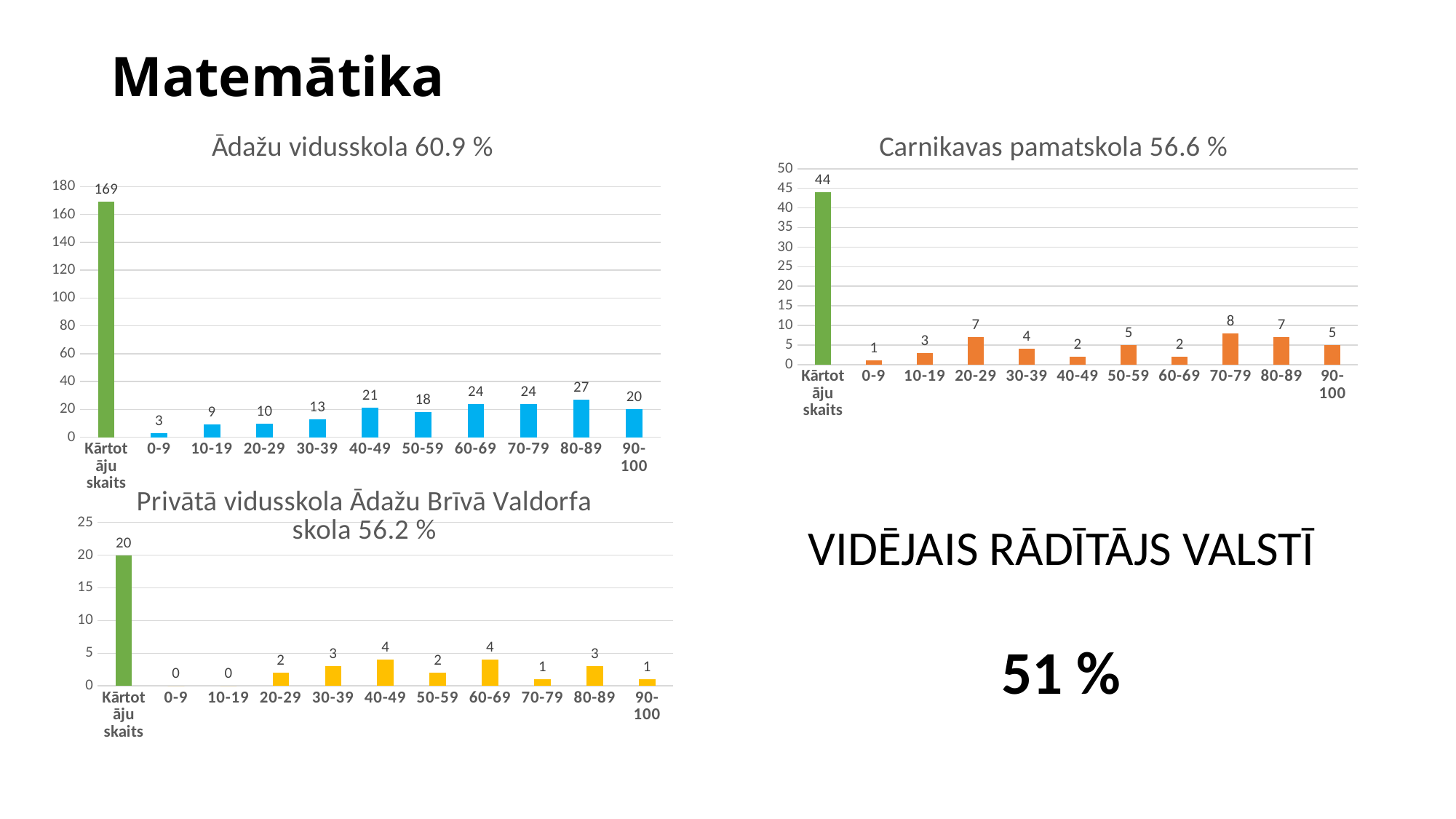
In the 'Ādažu vidusskola 60.9 %' chart, what is the value for the 80-89 category? 27 In the 'Carnikavas pamatskola 56.6 %' chart, is the value for 20-29 larger or smaller than the value for 30-39? larger In the 'Ādažu vidusskola 60.9 %' chart, what is the difference between the 80-89 and 0-9 values? 24 In the 'Ādažu vidusskola 60.9 %' chart, what is the value of the 'Kārtotāju skaits' bar? 169 In the 'Carnikavas pamatskola 56.6 %' chart, which score range (excluding 'Kārtotāju skaits') has the highest value? 70-79 What type of chart is the 'Carnikavas pamatskola 56.6 %' chart? bar chart In the 'Privātā vidusskola Ādažu Brīvā Valdorfa skola 56.2 %' chart, how many score ranges have a value of 0? 2 In the 'Carnikavas pamatskola 56.6 %' chart, what is the value for the 70-79 category? 8 How many charts are shown on the slide? 3 In the 'Privātā vidusskola Ādažu Brīvā Valdorfa skola 56.2 %' chart, what is the value for the 40-49 category? 4 In the 'Ādažu vidusskola 60.9 %' chart, which score range (excluding 'Kārtotāju skaits') has the lowest value? 0-9 In the 'Privātā vidusskola Ādažu Brīvā Valdorfa skola 56.2 %' chart, what is the value of the 'Kārtotāju skaits' bar? 20